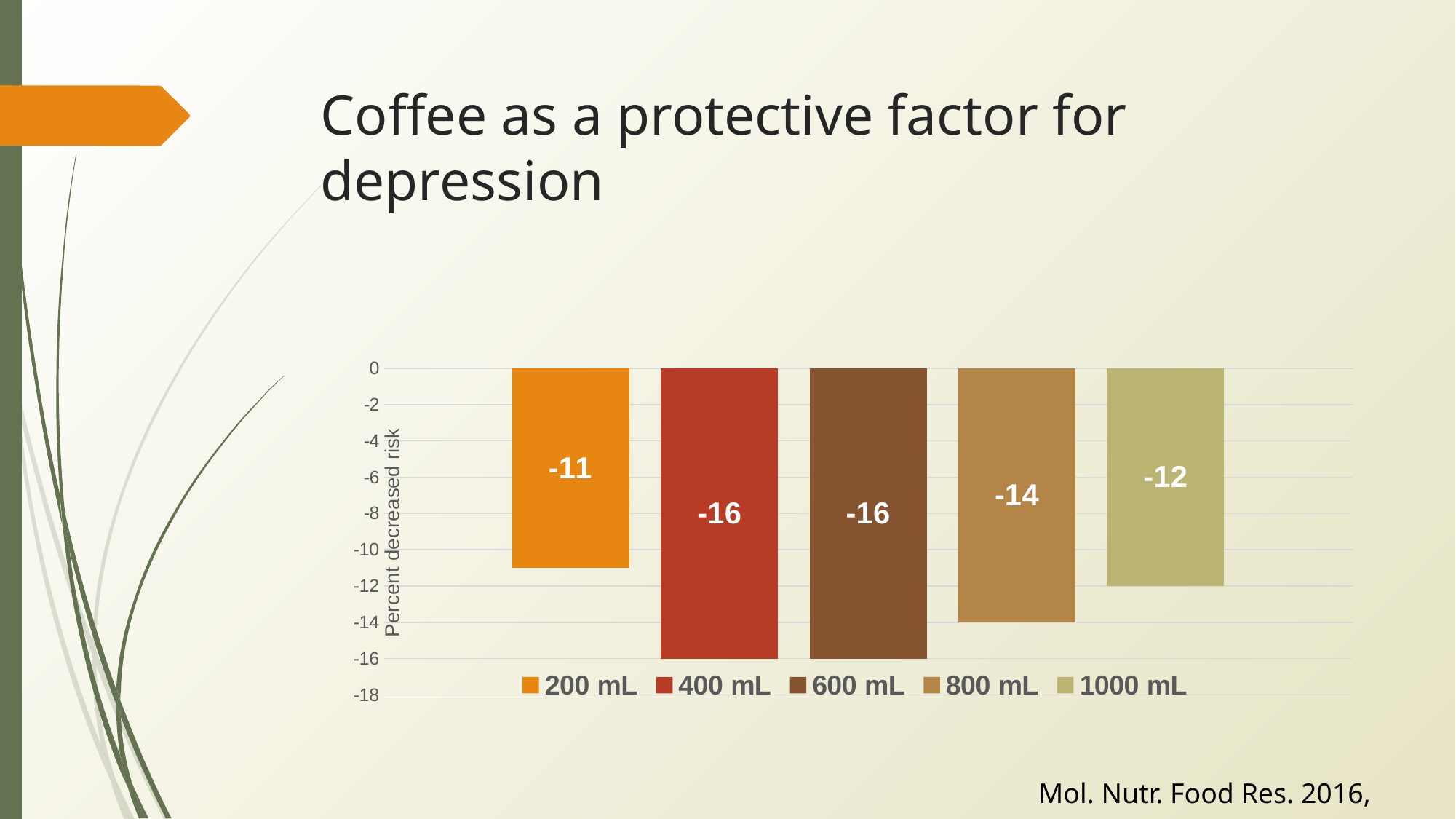
What is the percent decreased risk for 400 mL? -16 Which coffee amount shows the smallest decrease in risk (value closest to zero)? 200 mL Which has a larger decrease in risk, 600 mL or 1000 mL? 600 mL What is the difference between the values for 400 mL and 200 mL? 5 What type of chart is shown on the slide? Bar chart What is the percent decreased risk for 1000 mL? -12 How many coffee amounts are plotted in the chart? 5 What is the label of the vertical axis? Percent decreased risk What is the percent decreased risk for 800 mL? -14 What is the difference between the values for 800 mL and 1000 mL? 2 How many entries does the legend list? 5 What is the percent decreased risk for 200 mL? -11